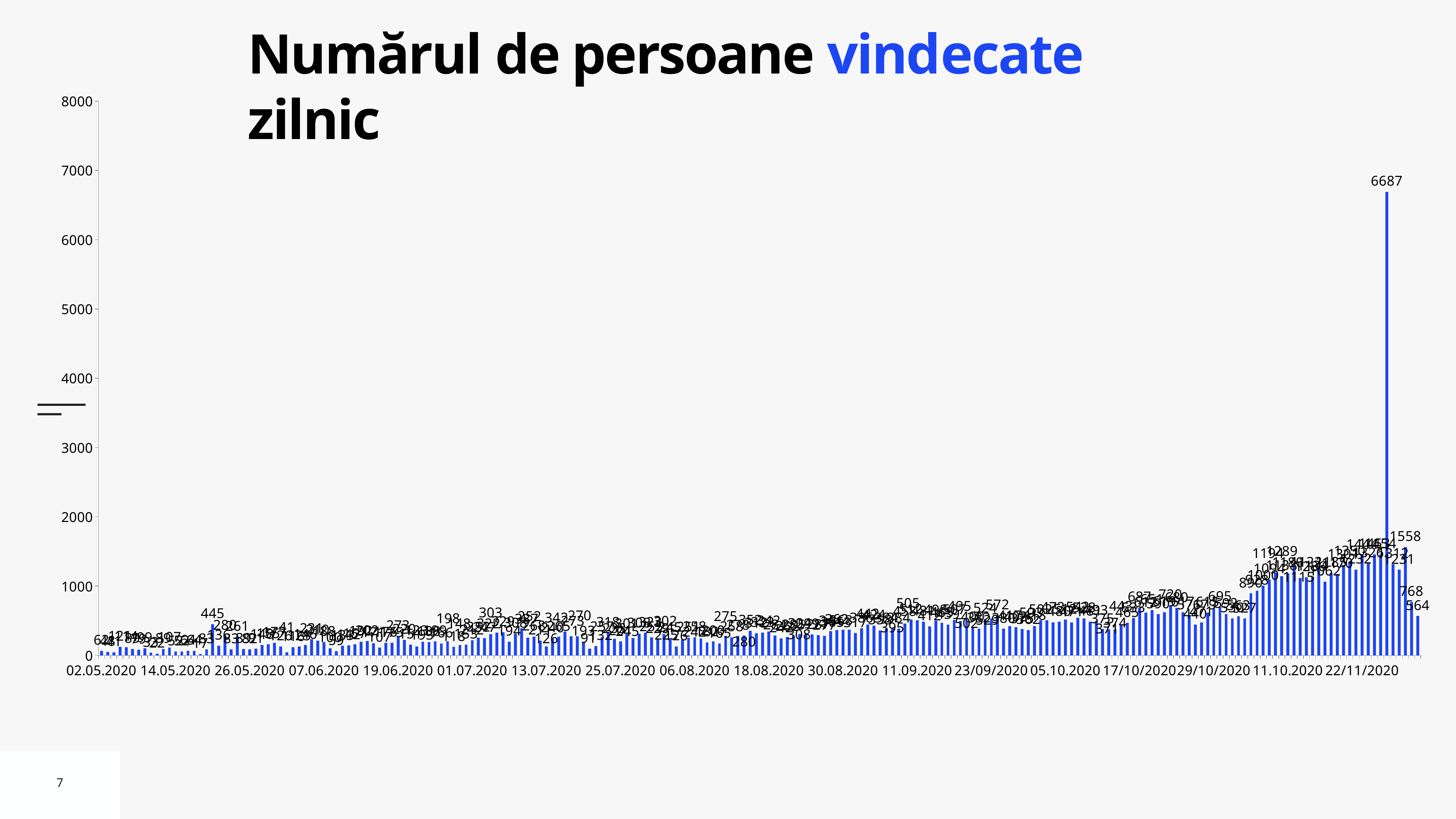
What is the maximum value shown on the vertical axis? 8000 What is the title of the chart? Numărul de persoane vindecate zilnic What is the difference between the highest labelled value, 6687, and the second-highest labelled value, 1558? 5129 Which is larger, the bar labelled 6687 or the bar labelled 1558? 6687 Is the highest bar on the chart greater or less than 6000? greater Is the value for 02.05.2020 greater or less than 1000? less What kind of chart is shown on the slide? bar chart What is the value labelled on the rightmost bar of the chart? 564 What is the highest value labelled on the chart? 6687 What is the first date label on the x axis? 02.05.2020 Do the daily values generally rise or fall from left to right along the x axis? rise What is the last date label on the x axis? 22/11/2020